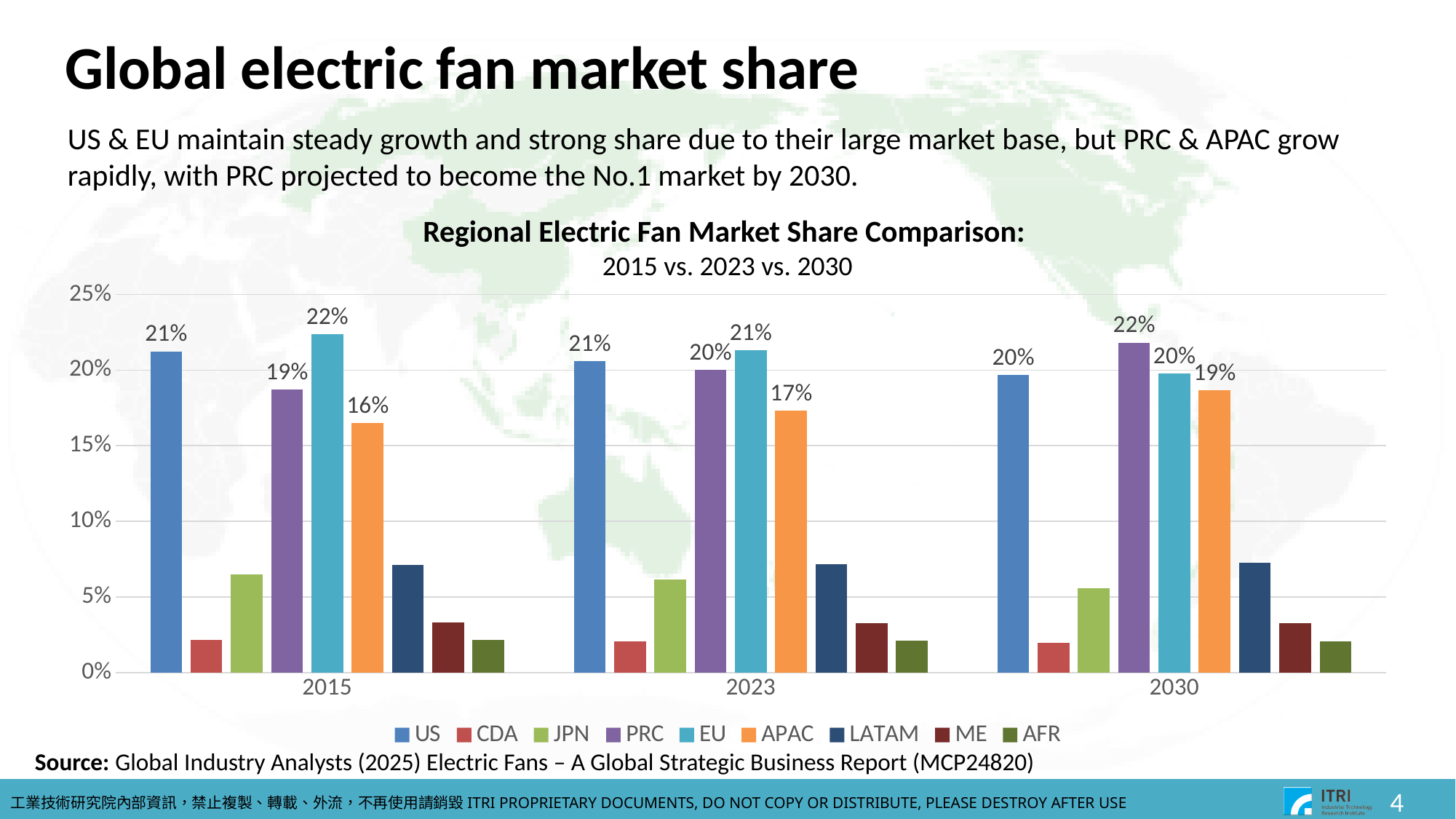
What is the market share of APAC in 2030? 19% How many series does the legend list? 9 In 2023, which is larger: the market share of PRC or APAC? PRC What kind of chart is shown on the slide? Bar chart How many year groups are shown on the x axis? 3 Which region has the highest market share in 2015? EU What is the market share of PRC in 2023? 20% Is the value for LATAM in 2023 greater or less than 10%? less What is the market share of EU in 2015? 22% Is the value for JPN in 2015 greater or less than 5%? greater What is the difference between the EU and APAC market shares in 2015? 6% Which region has the highest market share in 2030? PRC